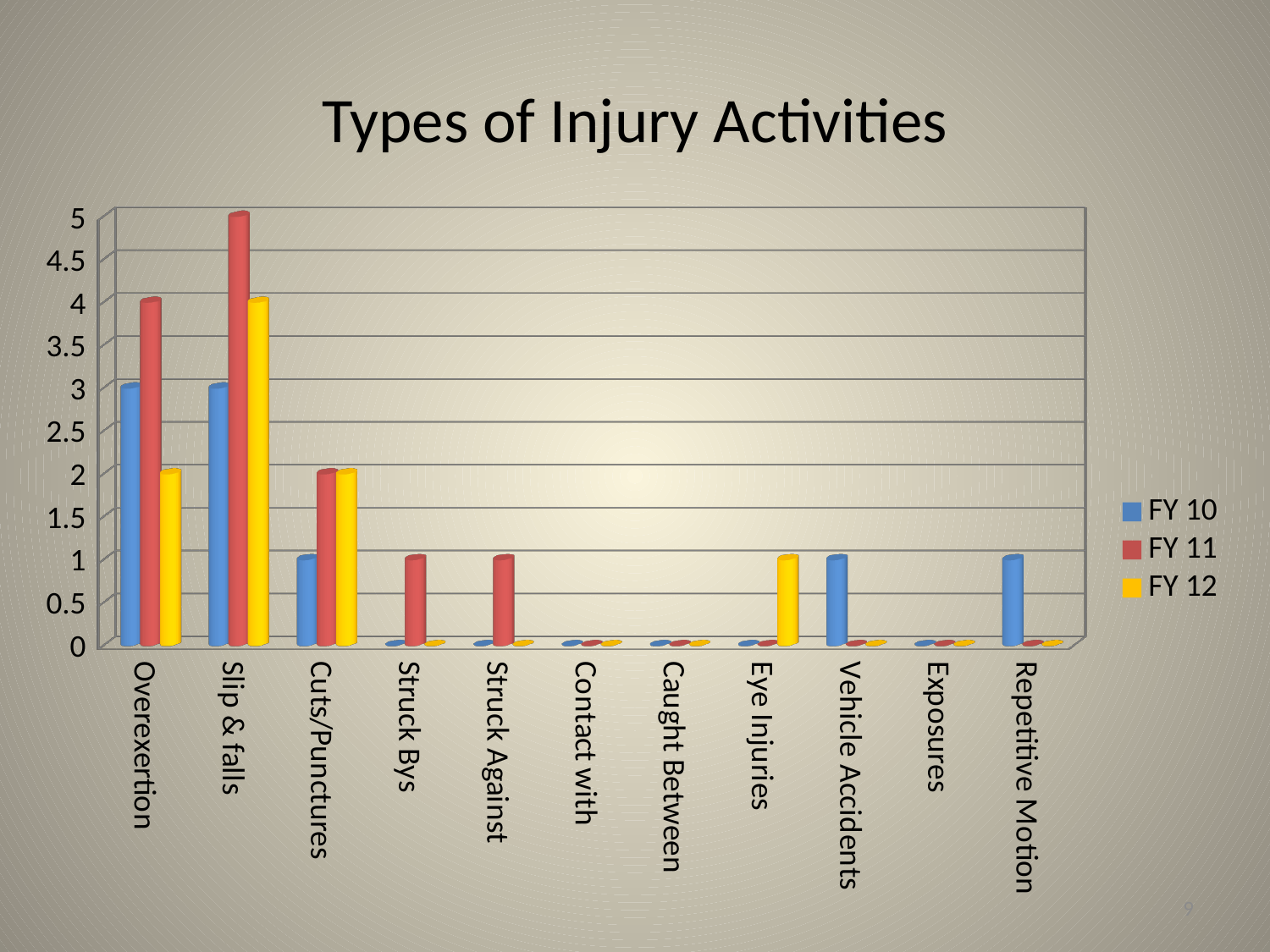
How many injury categories are shown on the x axis? 11 Which is larger for Slip & falls, the FY 12 value or the FY 10 value? FY 12 What type of chart is shown on the slide? Bar chart Which series is shown in yellow in the legend? FY 12 What is the difference between the FY 11 and FY 10 values for Overexertion? 1 Is the FY 11 value for Slip & falls greater or less than 4? greater Which category has the highest FY 11 value? Slip & falls What is the FY 12 value for Overexertion? 2 How many series does the legend list? 3 What is the FY 10 value for Cuts/Punctures? 1 What is the title of the chart? Types of Injury Activities What is the FY 11 value for Slip & falls? 5